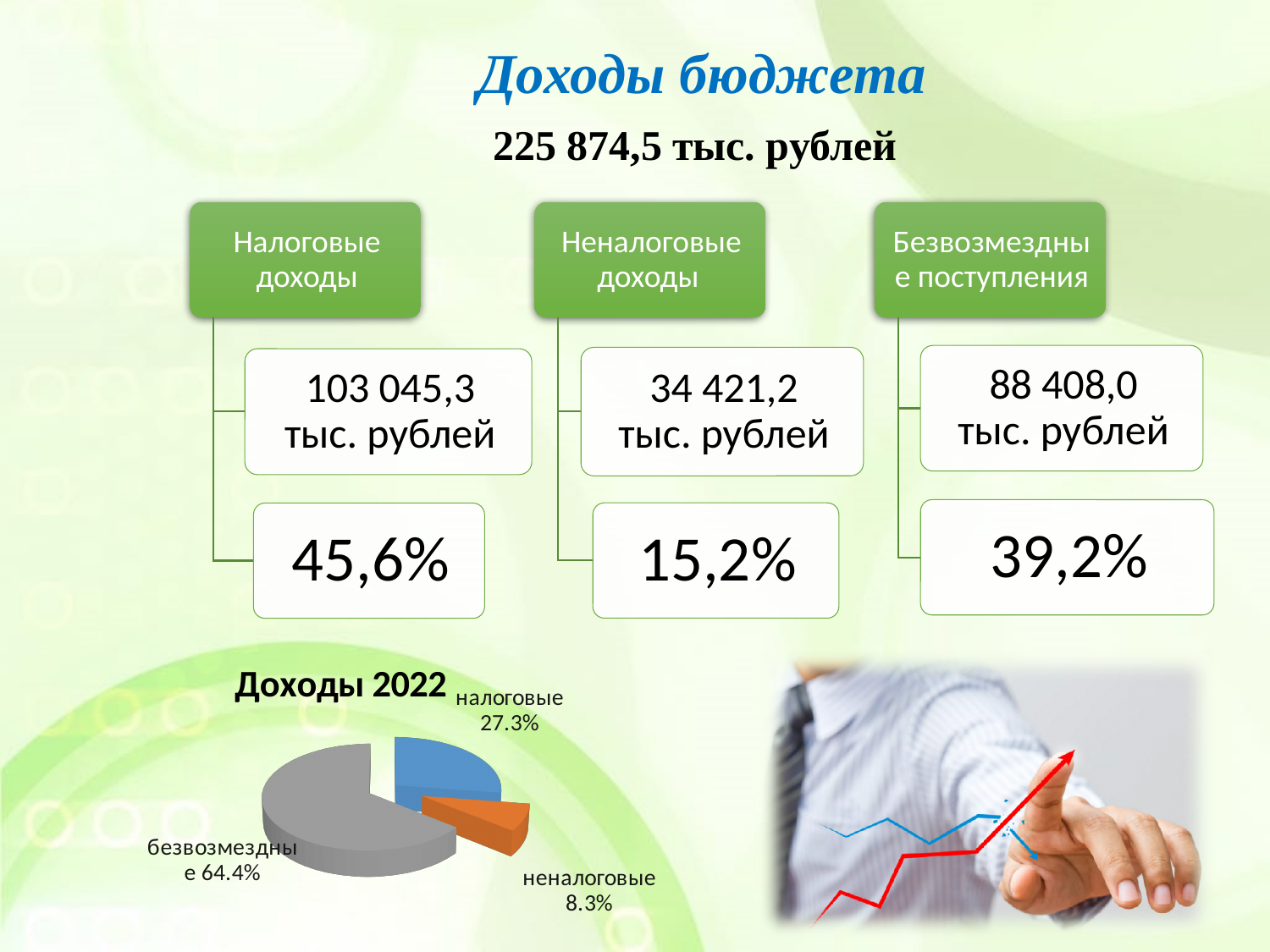
How many slices does the "Доходы 2022" pie chart have? 3 What colour is the безвозмездные slice in the "Доходы 2022" pie chart? grey Which slice of the "Доходы 2022" pie chart is the largest? безвозмездные What is the title of the pie chart on the slide? Доходы 2022 Which slice of the "Доходы 2022" pie chart is the smallest? неналоговые In the "Доходы 2022" pie chart, what is the difference in percentage points between безвозмездные and налоговые? 37.1 In the "Доходы 2022" pie chart, what share is labelled for безвозмездные? 64.4% What kind of chart is shown under the heading "Доходы 2022"? pie chart In the "Доходы 2022" pie chart, what is the difference in percentage points between налоговые and неналоговые? 19.0 In the "Доходы 2022" pie chart, what share is labelled for налоговые? 27.3% In the "Доходы 2022" pie chart, what share is labelled for неналоговые? 8.3% In the "Доходы 2022" pie chart, which is larger: налоговые or неналоговые? налоговые